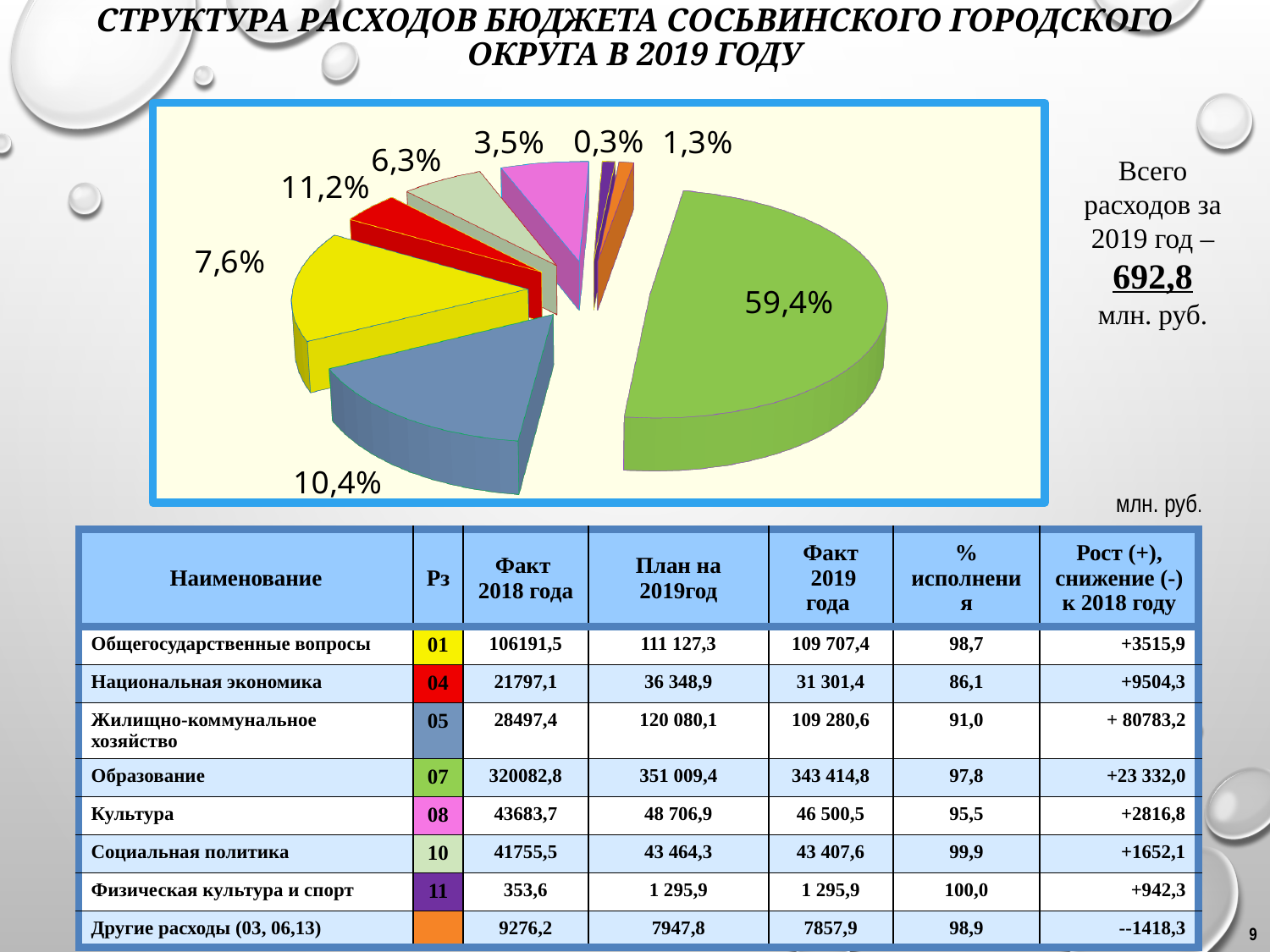
According to the text next to the pie chart, what was the total expenditure for 2019? 692,8 млн. руб. How many slices does the pie chart have? 8 What colour is the largest slice of the pie chart? green What kind of chart is shown on the slide? pie chart What is the share of the blue-grey slice at the bottom of the pie chart? 10,4% Is the largest slice of the pie chart greater or less than 50%? greater Which is larger in the pie chart: the slice labelled 10,4% or the slice labelled 7,6%? 10,4% What is the share of the smallest slice in the pie chart? 0,3% What is the share of the yellow slice in the pie chart? 7,6% What is the difference between the largest slice (59,4%) and the second largest slice (11,2%) in the pie chart? 48,2% What is the second largest share shown in the pie chart? 11,2% What is the share of the largest slice in the pie chart? 59,4%